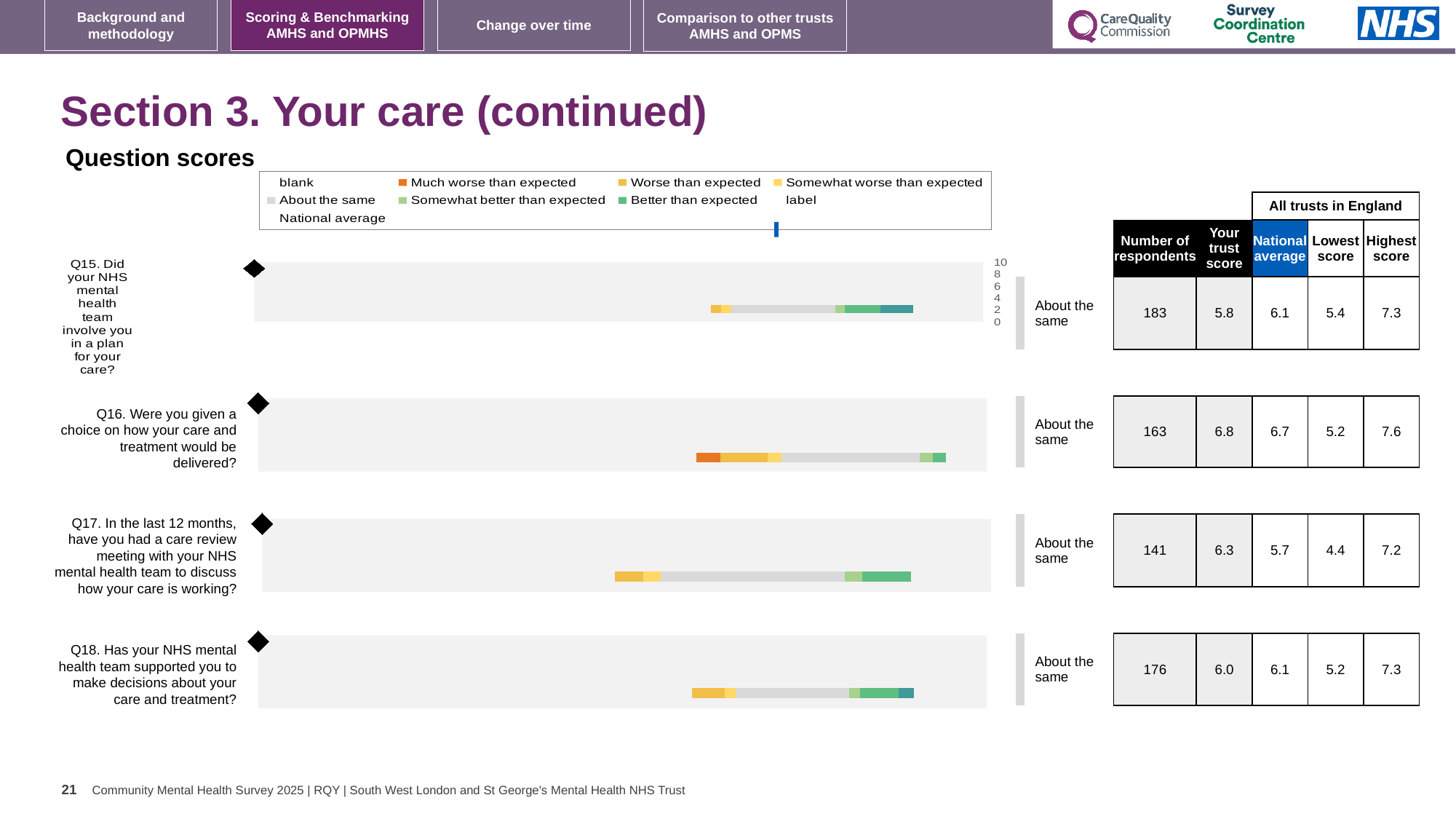
What kind of chart is used to show the question scores for Q15 to Q18? Bar chart What is the trust score for Q17 (care review meeting in the last 12 months)? 6.3 For Q17, which is larger: the trust score or the national average? Trust score Which question has the lowest number of respondents? Q17 Which question has the highest trust score on this slide? Q16 What benchmark category label is shown beside the Q15 bar? About the same What is the highest score among all trusts in England for Q18? 7.3 What is the national average for Q15 (involving you in a plan for your care)? 6.1 What is the lowest score among all trusts in England for Q18? 5.2 For Q16, how many respondents are shown in the table next to the chart? 163 How many questions (Q15 to Q18) have a score bar plotted on the slide? 4 For Q16, what is the difference between the highest score and the lowest score among all trusts in England? 2.4